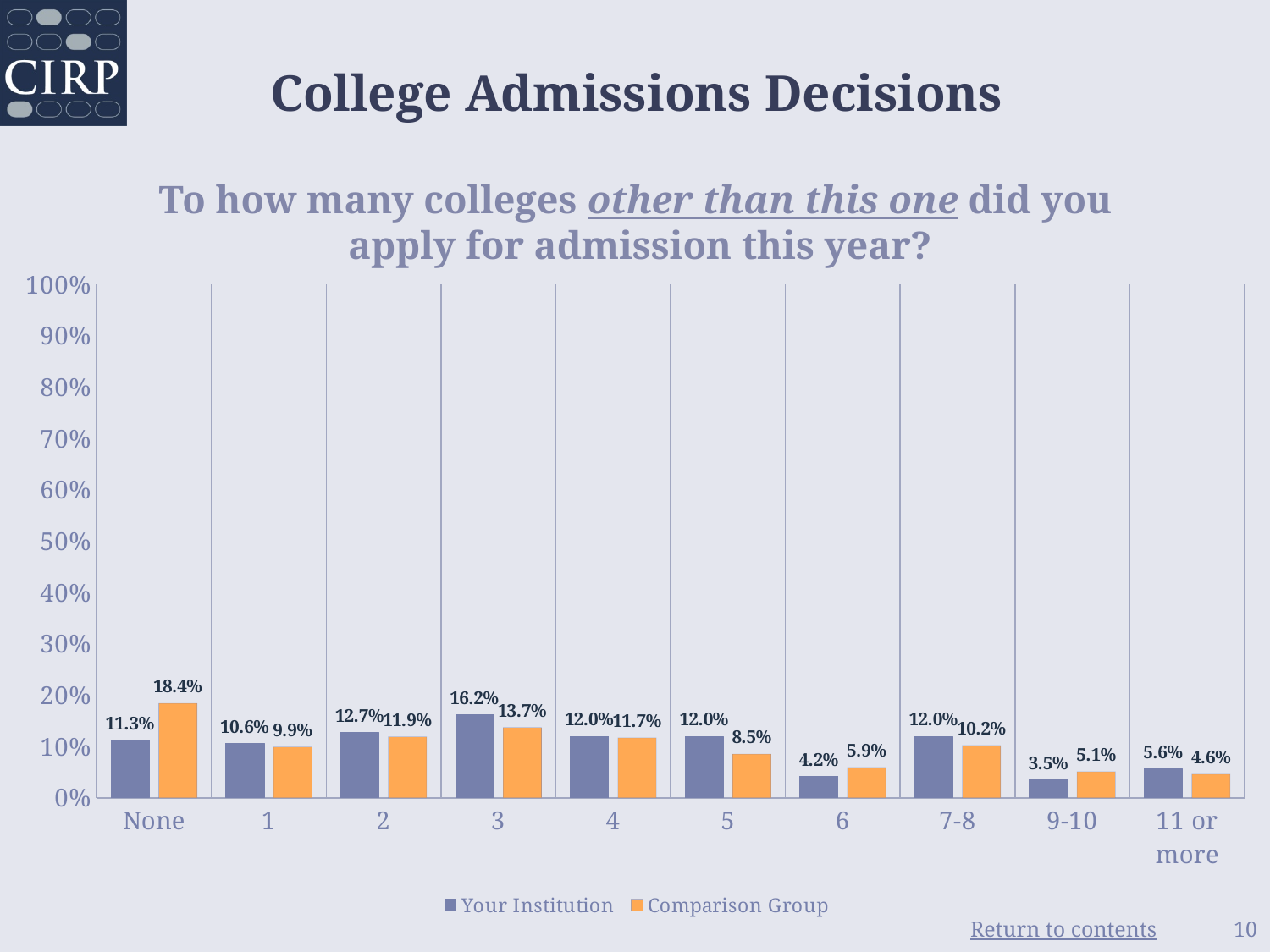
What kind of chart is shown on the slide? Bar chart What is the Comparison Group value for the 'None' category? 18.4% What is the Comparison Group value for the '11 or more' category? 4.6% Which category has the highest Your Institution value? 3 What is the Your Institution value for the '3' category? 16.2% Which category has the highest Comparison Group value? None For the '5' category, which is larger: Your Institution or Comparison Group? Your Institution Which category has the lowest Your Institution value? 9-10 How many series does the legend list? 2 What is the difference between the Comparison Group and Your Institution values for the 'None' category? 7.1 percentage points What is the Your Institution value for the '9-10' category? 3.5% How many categories are shown on the x axis? 10